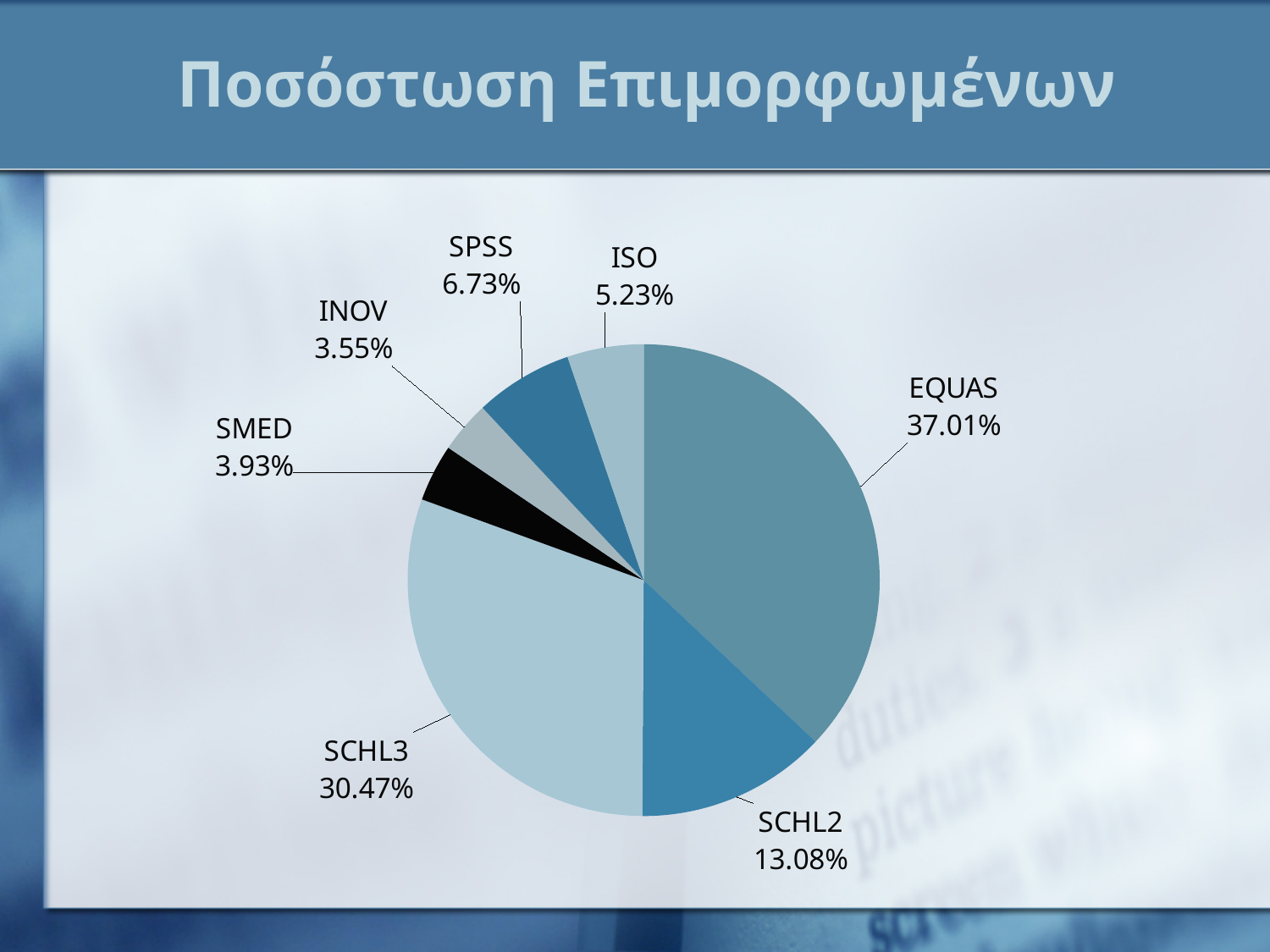
Which category has the largest slice of the pie? EQUAS What is the title of the chart on the slide? Ποσόστωση Επιμορφωμένων What is the share for ISO? 5.23% What is the share for EQUAS? 37.01% What is the share for SCHL2? 13.08% What is the share for SPSS? 6.73% Which is larger, the share for SMED or the share for INOV? SMED How many slices does the pie chart have? 7 What is the difference in percentage points between EQUAS and SCHL3? 6.54 What is the share for SCHL3? 30.47% What type of chart is shown on the slide? pie chart Which category has the smallest slice of the pie? INOV